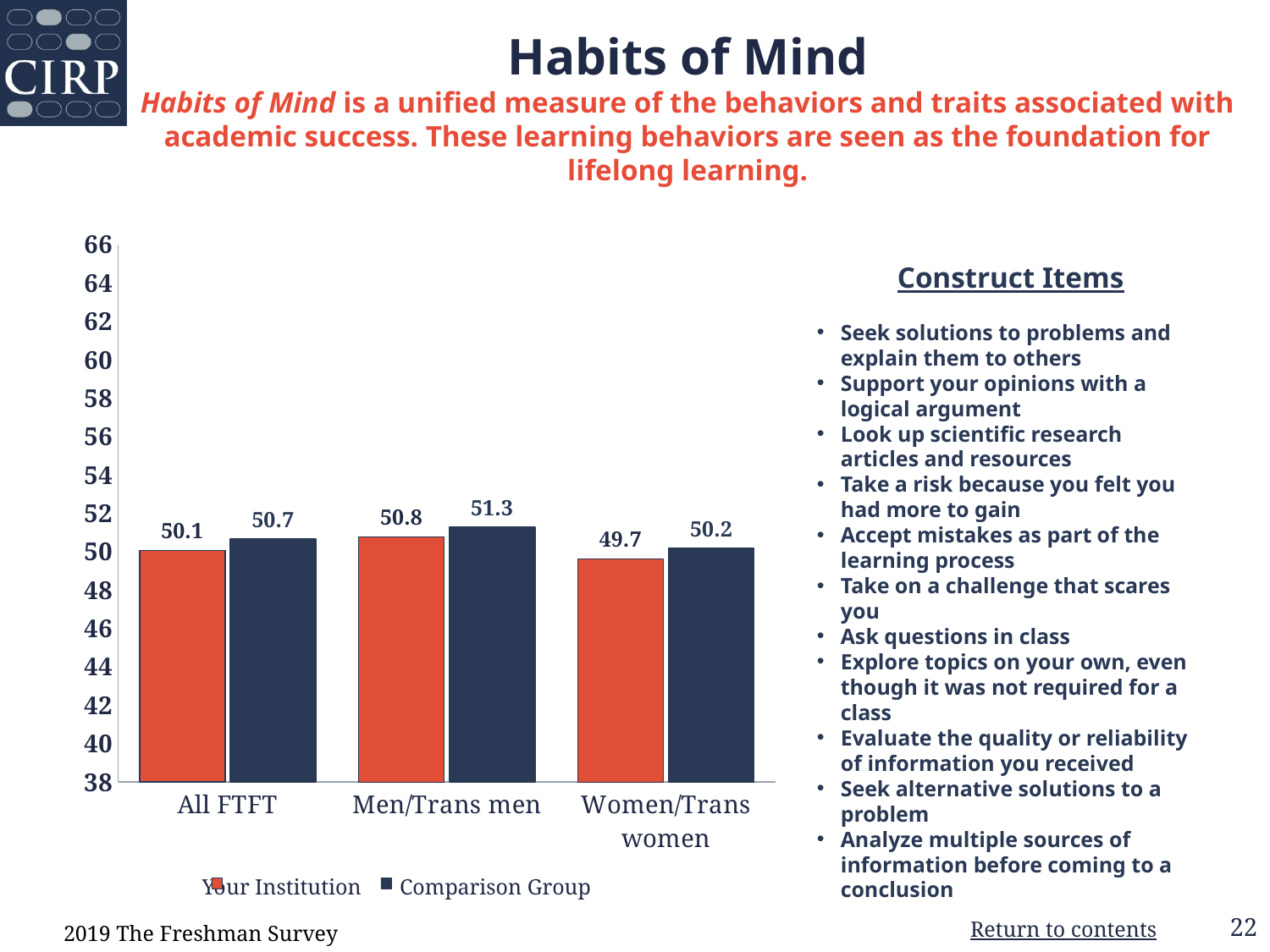
What is the difference between the Comparison Group and Your Institution values for All FTFT? 0.6 How many categories are shown on the x axis? 3 For Men/Trans men, which is larger: Your Institution or Comparison Group? Comparison Group Which category has the highest Comparison Group value? Men/Trans men What is the Your Institution value for Women/Trans women? 49.7 What is the Comparison Group value for All FTFT? 50.7 What is the Comparison Group value for Men/Trans men? 51.3 Which category has the lowest Your Institution value? Women/Trans women What is the difference between the Comparison Group and Your Institution values for Women/Trans women? 0.5 What is the Your Institution value for All FTFT? 50.1 How many series does the legend list? 2 What kind of chart is shown on the slide? Bar chart